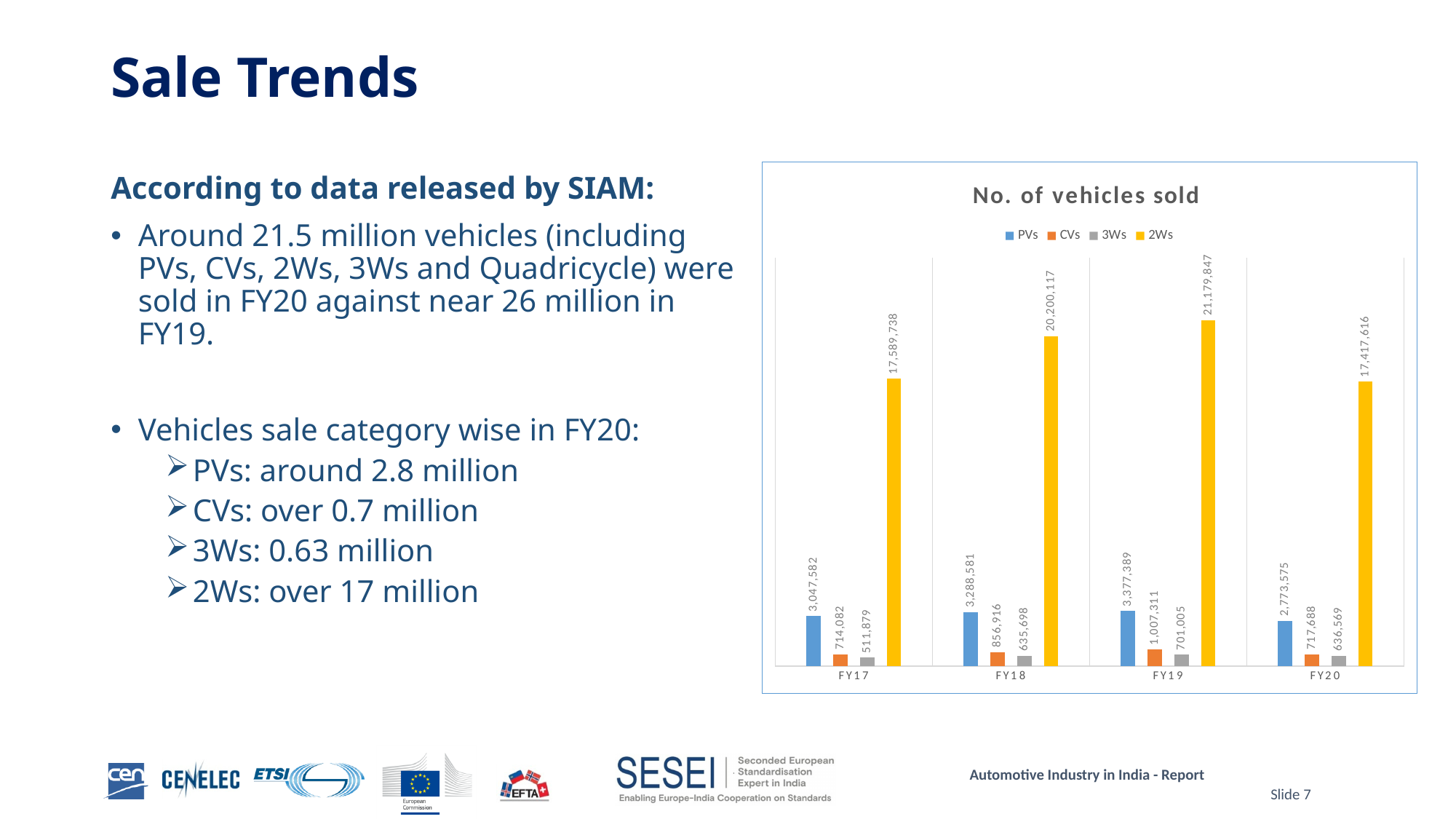
In which fiscal year were 2Ws sales the highest? FY19 What is the title of the chart? No. of vehicles sold How many series does the chart legend list? 4 What is the number of 3Ws sold in FY17? 511,879 What is the number of PVs sold in FY20? 2,773,575 In which fiscal year were PVs sales the lowest? FY20 What is the number of CVs sold in FY18? 856,916 How many fiscal years are shown on the x axis of the chart? 4 Which is larger: CVs sold in FY19 or CVs sold in FY20? CVs sold in FY19 What type of chart is shown on the slide? Bar chart What is the number of 2Ws sold in FY19? 21,179,847 What is the difference between 2Ws sold in FY19 and FY20? 3,762,231